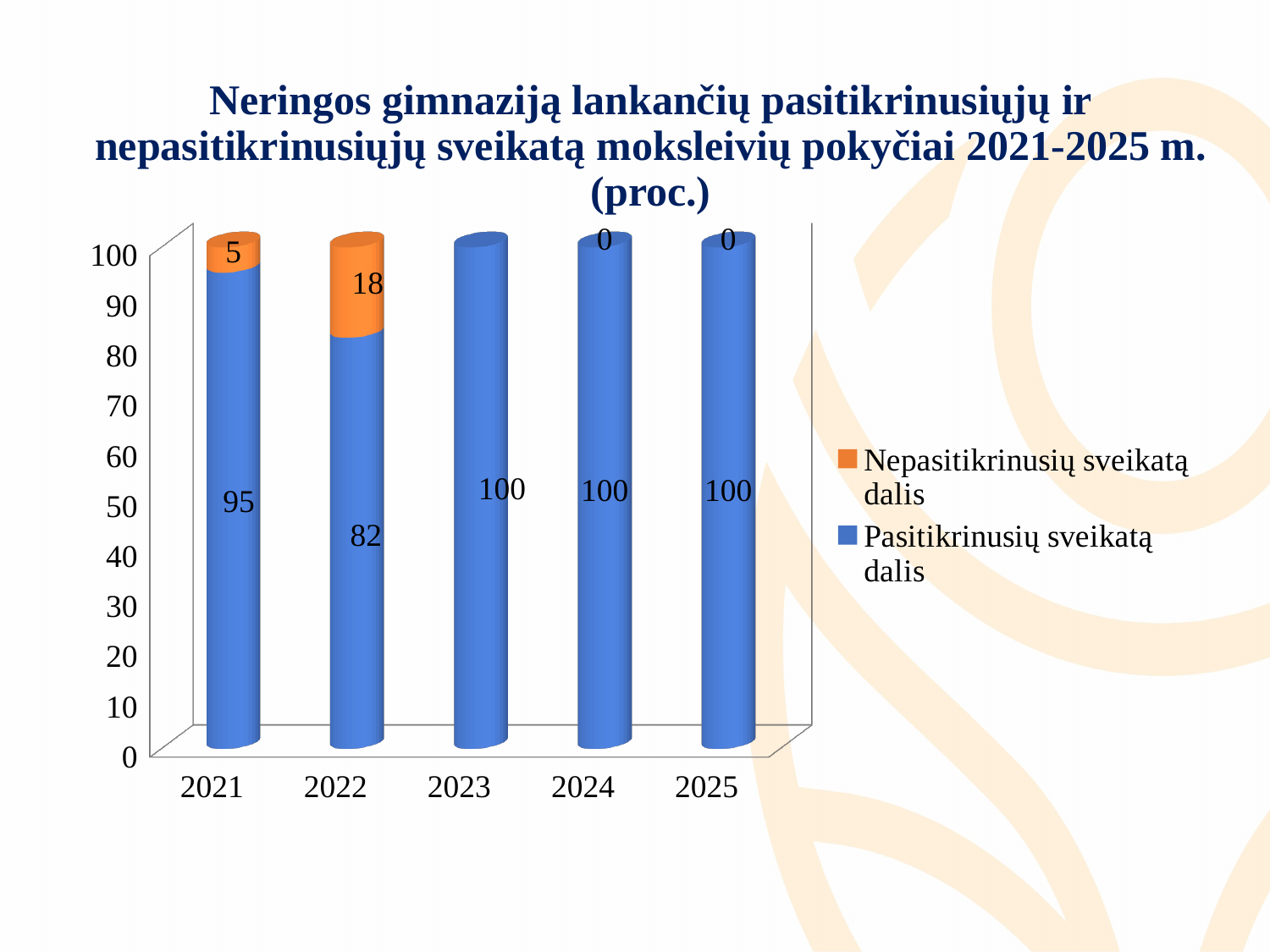
How many series does the legend list? 2 Which is larger: 'Nepasitikrinusių sveikatą dalis' in 2021 or in 2022? 2022 What is the value of 'Nepasitikrinusių sveikatą dalis' for 2022? 18 What kind of chart is shown on the slide? Stacked bar chart How many years are shown on the x axis? 5 What is the difference between 'Pasitikrinusių sveikatą dalis' in 2021 and 2022? 13 What is the value of 'Pasitikrinusių sveikatą dalis' for 2024? 100 What is the value of 'Nepasitikrinusių sveikatą dalis' for 2021? 5 What is the value of 'Pasitikrinusių sveikatą dalis' for 2022? 82 In which year is 'Pasitikrinusių sveikatą dalis' lowest? 2022 In which year is 'Nepasitikrinusių sveikatą dalis' highest? 2022 What is the total of the stacked bar for 2022? 100